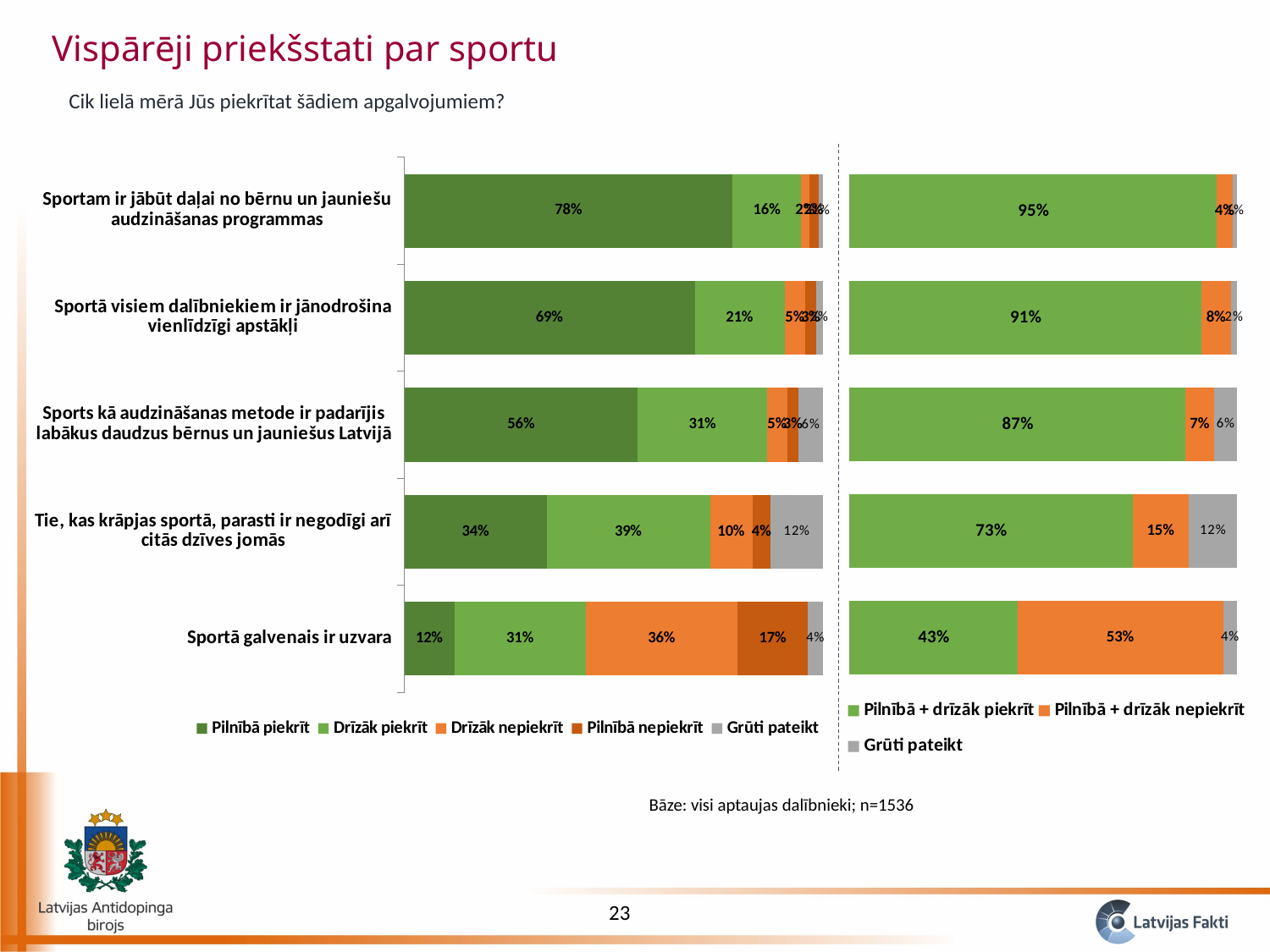
In the left chart, for the statement 'Sportā galvenais ir uzvara', what is the difference between the 'Drīzāk nepiekrīt' and 'Pilnībā nepiekrīt' values? 19 percentage points In the right chart, which statement has the lowest 'Pilnībā + drīzāk piekrīt' value? Sportā galvenais ir uzvara In the left chart, which statement has a higher 'Pilnībā piekrīt' value: 'Sportā visiem dalībniekiem ir jānodrošina vienlīdzīgi apstākļi' or 'Sports kā audzināšanas metode ir padarījis labākus daudzus bērnus un jauniešus Latvijā'? Sportā visiem dalībniekiem ir jānodrošina vienlīdzīgi apstākļi How many series does the legend of the right chart list? 3 In the left chart, what percentage of respondents answered 'Pilnībā piekrīt' to the statement 'Sportā galvenais ir uzvara'? 12% What kind of chart is the left chart? Stacked bar chart How many series does the legend of the left chart list? 5 In the right chart, what is the 'Pilnībā + drīzāk piekrīt' value for the statement 'Sportam ir jābūt daļai no bērnu un jauniešu audzināšanas programmas'? 95% In the right chart, for the statement 'Sportā galvenais ir uzvara', how much larger is the 'Pilnībā + drīzāk nepiekrīt' value than the 'Pilnībā + drīzāk piekrīt' value? 10 percentage points In the left chart, what is the 'Drīzāk piekrīt' value for the statement 'Tie, kas krāpjas sportā, parasti ir negodīgi arī citās dzīves jomās'? 39% In the right chart, what is the 'Grūti pateikt' value for the statement 'Tie, kas krāpjas sportā, parasti ir negodīgi arī citās dzīves jomās'? 12% In the left chart, which statement has the highest 'Pilnībā piekrīt' value? Sportam ir jābūt daļai no bērnu un jauniešu audzināšanas programmas